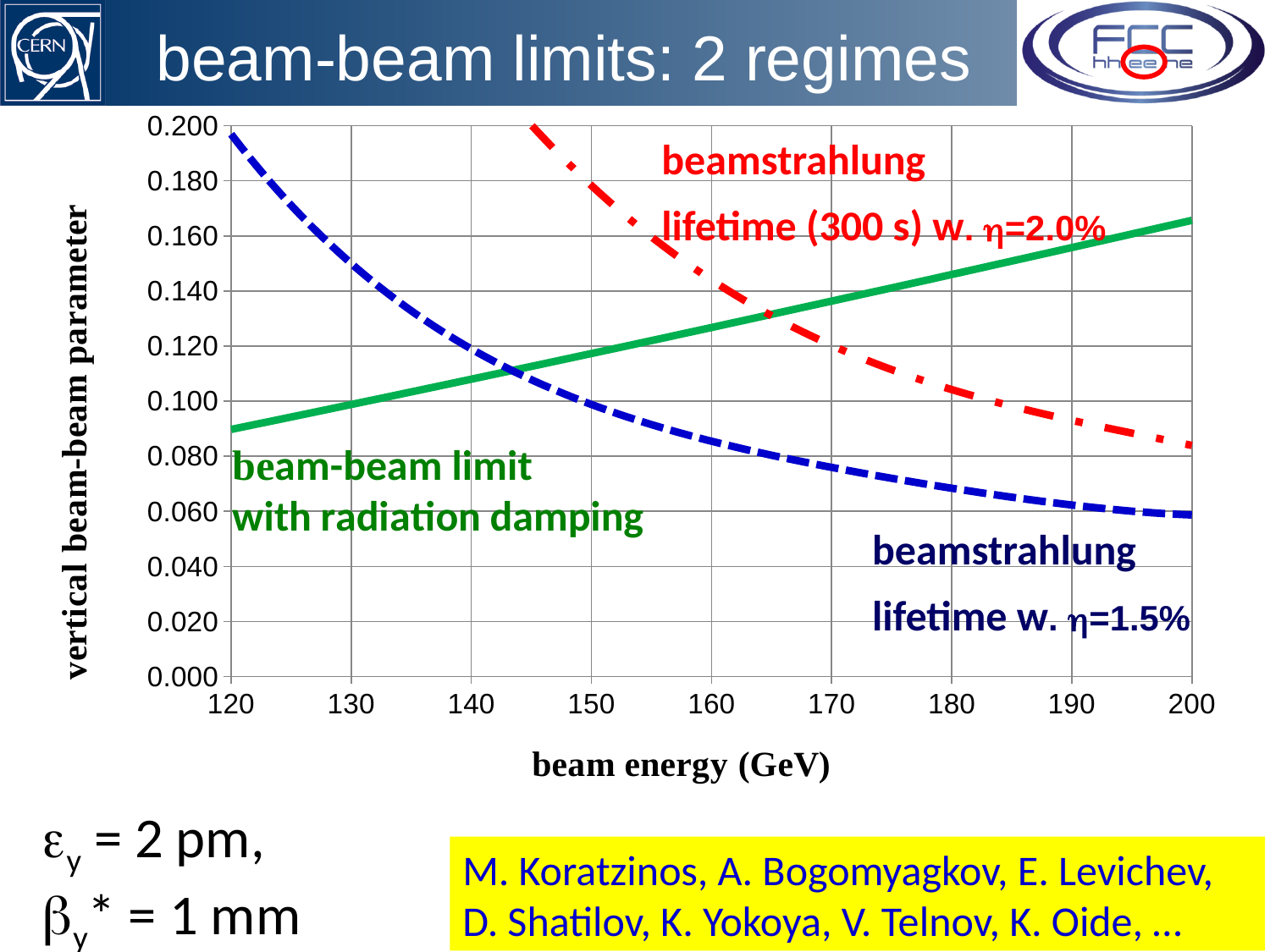
What is the label of the y axis? vertical beam-beam parameter How many curves are plotted on the chart? 3 What kind of chart is shown on the slide? line chart At 200 GeV, is the red dash-dot η=2.0% curve greater or less than 0.100? less Does the green 'beam-beam limit with radiation damping' curve rise or fall as beam energy increases from 120 to 200 GeV? rise At 200 GeV, which curve is higher: the green beam-beam limit curve or the blue dashed η=1.5% curve? the green beam-beam limit curve What is the label of the x axis? beam energy (GeV) At 200 GeV, is the blue dashed η=1.5% curve greater or less than 0.080? less At 120 GeV, is the green beam-beam limit curve greater or less than 0.080? greater At 120 GeV, which curve is higher: the blue dashed η=1.5% curve or the green beam-beam limit curve? the blue dashed η=1.5% curve Does the blue dashed 'beamstrahlung lifetime w. η=1.5%' curve rise or fall as beam energy increases? fall Does the red dash-dot 'beamstrahlung lifetime (300 s) w. η=2.0%' curve rise or fall as beam energy increases? fall